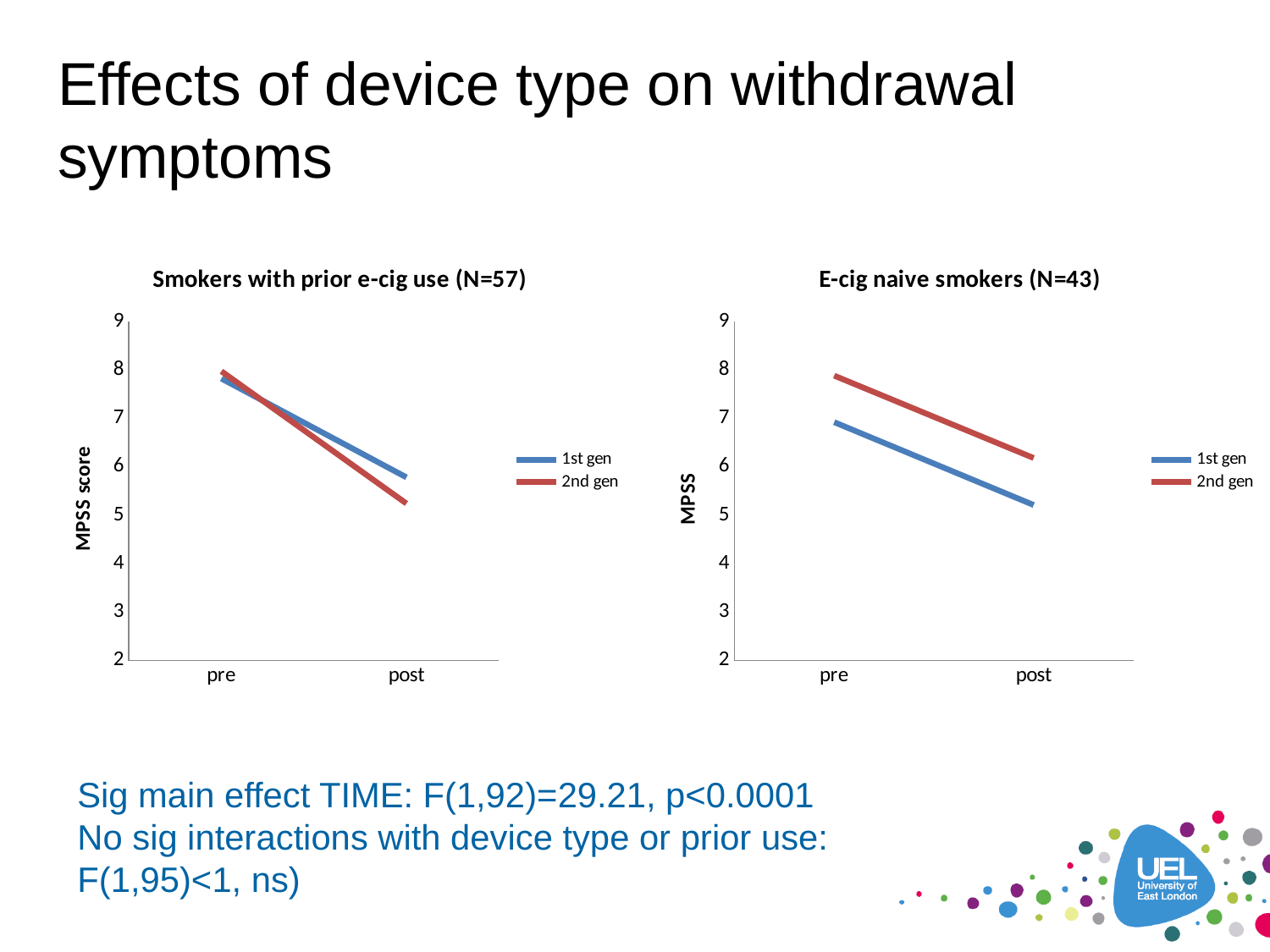
In the 'E-cig naive smokers (N=43)' chart, do the 1st gen values rise or fall from pre to post? fall In the 'Smokers with prior e-cig use (N=57)' chart, is the 2nd gen value at post greater or less than 6? less How many series does the legend of the 'E-cig naive smokers (N=43)' chart list? 2 How many points are on the x axis of the 'Smokers with prior e-cig use (N=57)' chart? 2 What is the y-axis label of the 'Smokers with prior e-cig use (N=57)' chart? MPSS score In the 'Smokers with prior e-cig use (N=57)' chart, do the 2nd gen values rise or fall from pre to post? fall What kind of chart is the 'Smokers with prior e-cig use (N=57)' chart? line chart In the 'E-cig naive smokers (N=43)' chart, is the 1st gen value at post greater or less than 6? less In the 'Smokers with prior e-cig use (N=57)' chart, is the 1st gen value at pre greater or less than 7? greater In the 'Smokers with prior e-cig use (N=57)' chart, which series has the higher value at post, 1st gen or 2nd gen? 1st gen In the 'E-cig naive smokers (N=43)' chart, which series has the higher value at pre, 1st gen or 2nd gen? 2nd gen